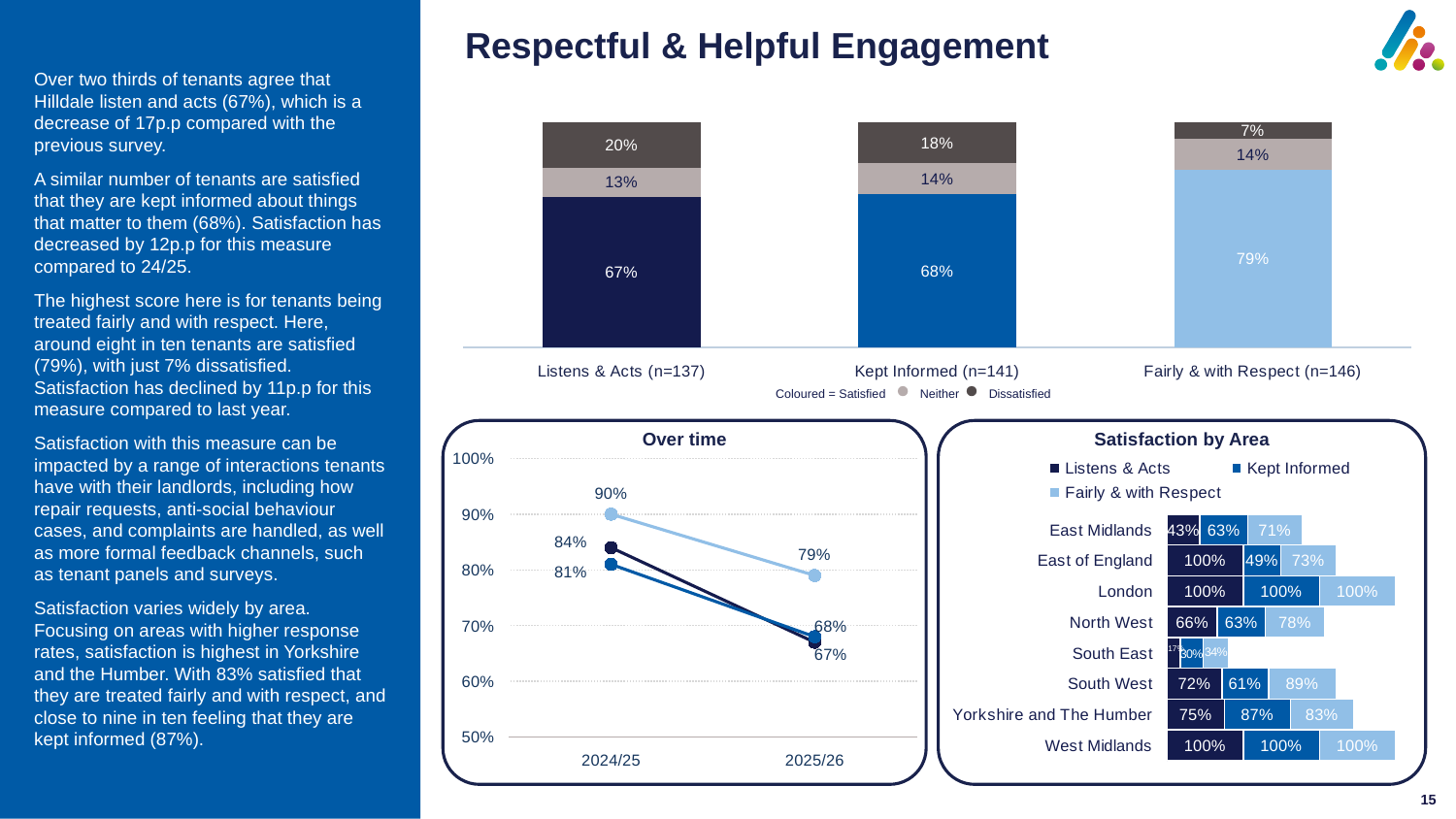
In the 'Over time' chart, what is the lowest value shown for 2025/26? 67% In the 'Over time' chart, what is the highest value shown for 2024/25? 90% In the 'Satisfaction by Area' chart, what is the Kept Informed value for Yorkshire and The Humber? 87% What type of chart is the 'Over time' chart? line chart In the top stacked bar chart, what percentage of tenants are satisfied that Hilldale Listens & Acts? 67% In the top stacked bar chart, which measure has the highest satisfied percentage? Fairly & with Respect In the top stacked bar chart, what is the sample size (n) shown for Kept Informed? 141 In the 'Satisfaction by Area' chart, how many areas are shown? 8 In the 'Satisfaction by Area' chart, how many series does the legend list? 3 In the top stacked bar chart, what percentage of tenants are dissatisfied with being treated Fairly & with Respect? 7% In the 'Over time' chart, do the lines rise or fall from 2024/25 to 2025/26? fall In the top stacked bar chart, what is the difference between the dissatisfied percentages for Listens & Acts and Kept Informed? 2 percentage points